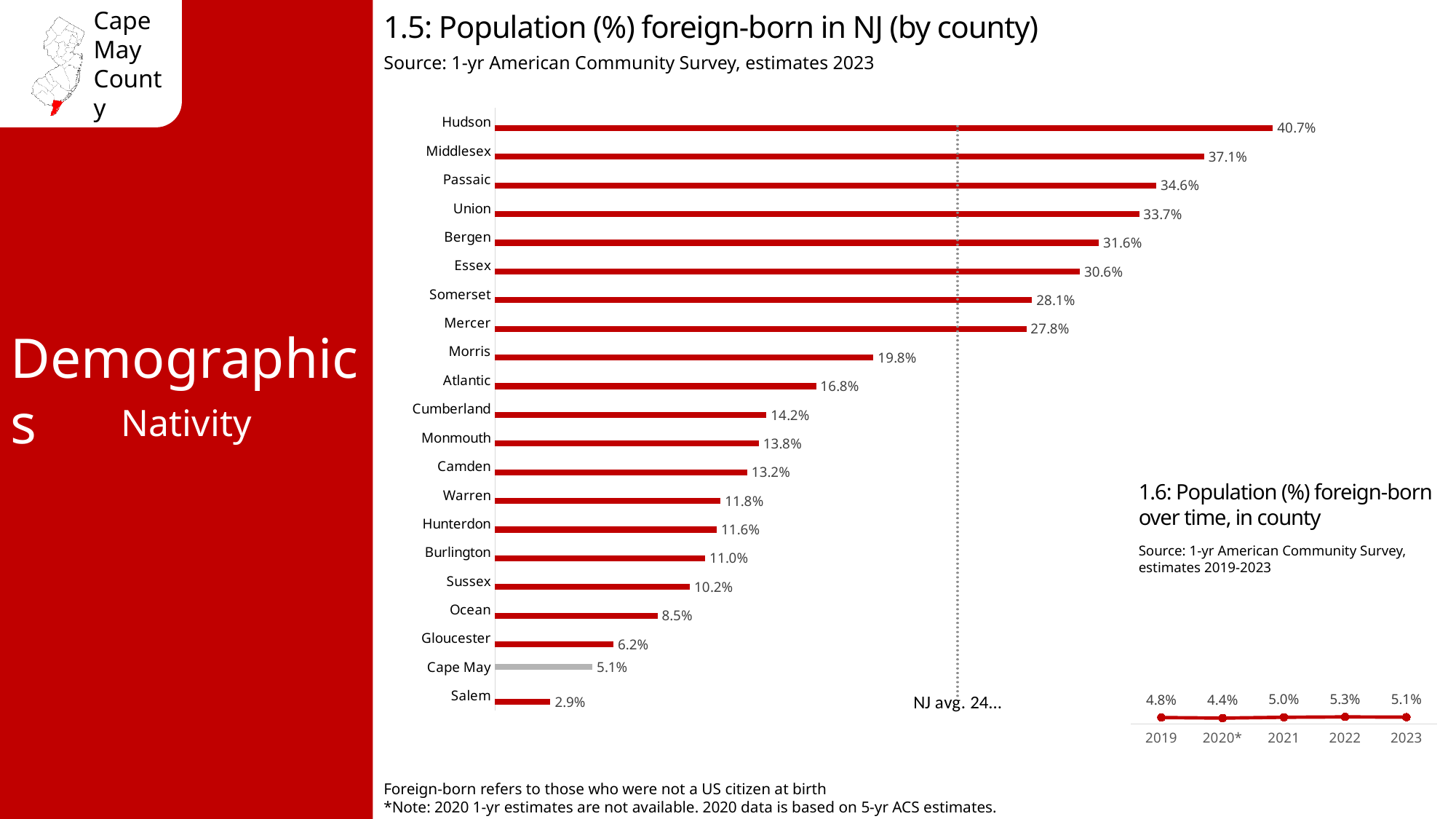
In chart 1.6 (Population (%) foreign-born over time, in county), how many years are plotted? 5 In chart 1.5 (Population (%) foreign-born in NJ by county), which county has the lowest value? Salem What kind of chart is chart 1.5 (Population (%) foreign-born in NJ by county)? Bar chart In chart 1.5 (Population (%) foreign-born in NJ by county), which county's bar is shown in grey instead of red? Cape May In chart 1.5 (Population (%) foreign-born in NJ by county), what is the value for Cape May? 5.1% In chart 1.5 (Population (%) foreign-born in NJ by county), which county has the highest value? Hudson In chart 1.5 (Population (%) foreign-born in NJ by county), what is the difference between Hudson and Middlesex? 3.6% In chart 1.6 (Population (%) foreign-born over time, in county), which year has the lowest value? 2020* In chart 1.6 (Population (%) foreign-born over time, in county), what is the value for 2022? 5.3% In chart 1.5 (Population (%) foreign-born in NJ by county), what is the value for Bergen? 31.6% In chart 1.5 (Population (%) foreign-born in NJ by county), how many counties are shown? 21 In chart 1.5 (Population (%) foreign-born in NJ by county), which is larger, Atlantic or Cumberland? Atlantic